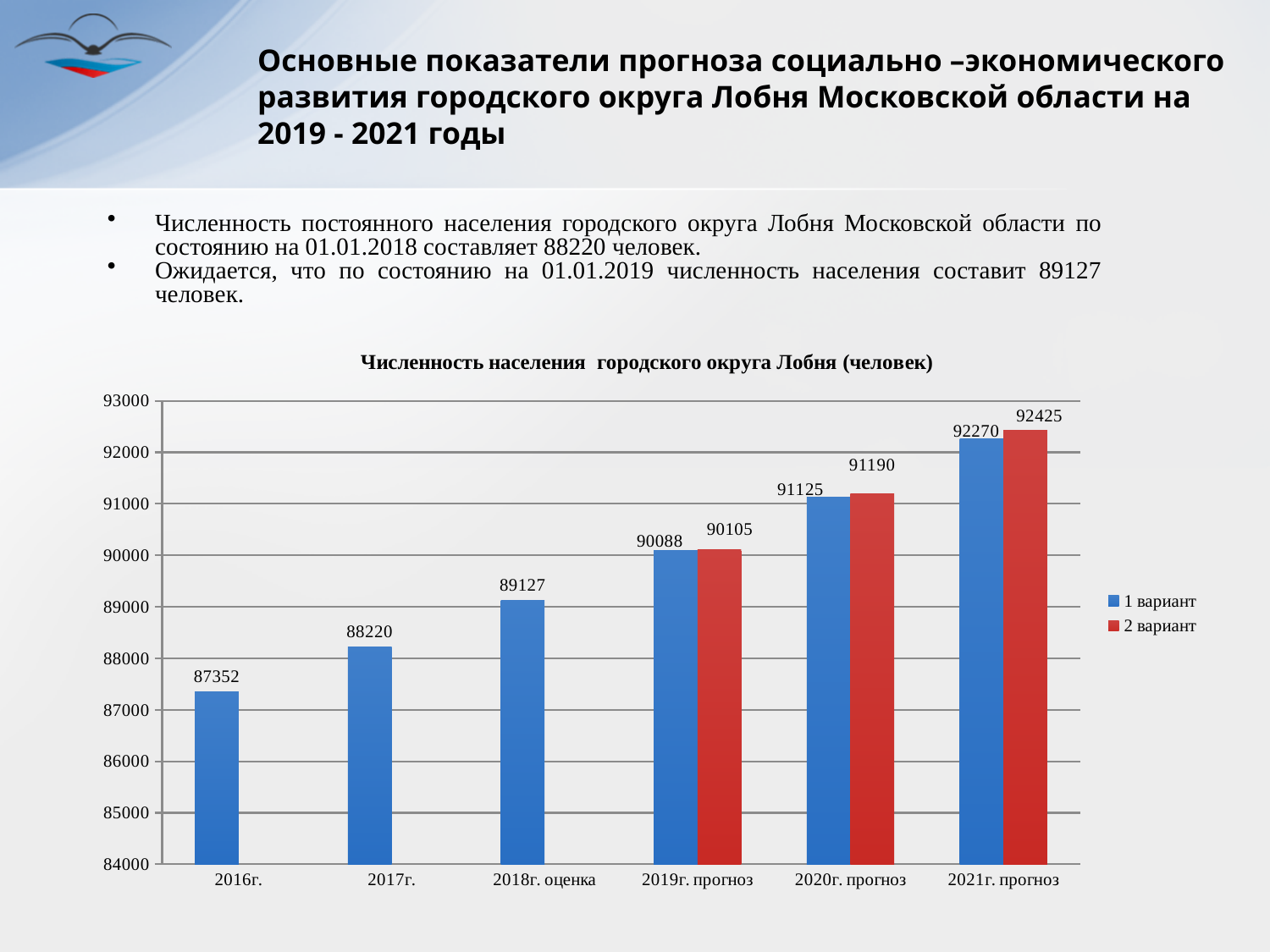
Which is larger for 2021г. прогноз: "1 вариант" or "2 вариант"? 2 вариант Do the "1 вариант" values rise or fall from 2016г. to 2021г. прогноз? rise What is the difference between "2 вариант" and "1 вариант" for 2020г. прогноз? 65 What is the value of "2 вариант" for 2021г. прогноз? 92425 What is the difference between the "1 вариант" values for 2017г. and 2016г.? 868 How many series does the legend list? 2 How many categories are shown on the x axis? 6 What is the value of "1 вариант" for 2019г. прогноз? 90088 Which category has the lowest value for "1 вариант"? 2016г. Which category has the highest value for "2 вариант"? 2021г. прогноз What is the value of "1 вариант" for 2016г.? 87352 Is the value of "1 вариант" for 2018г. оценка greater or less than 90000? less